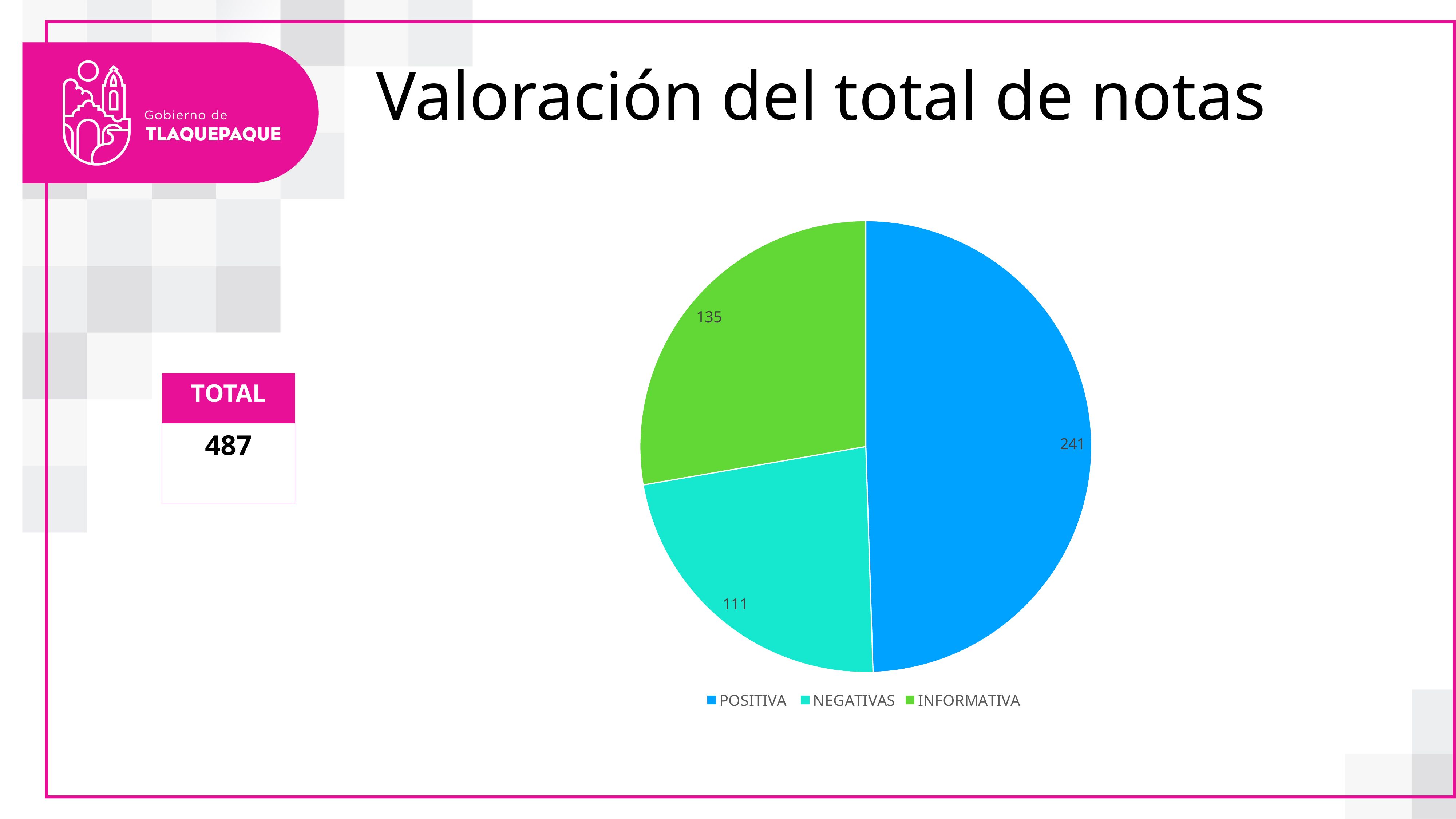
Which category has the smallest slice? NEGATIVAS What kind of chart is shown on the slide? Pie chart What is the total of all slices in the pie chart? 487 What is the value for POSITIVA? 241 What is the value for INFORMATIVA? 135 What is the difference between the INFORMATIVA and NEGATIVAS values? 24 Which category has the largest slice? POSITIVA What is the difference between the POSITIVA and NEGATIVAS values? 130 What colour is the POSITIVA slice? Blue How many categories does the pie chart show? 3 What is the value for NEGATIVAS? 111 Which is larger, INFORMATIVA or NEGATIVAS? INFORMATIVA